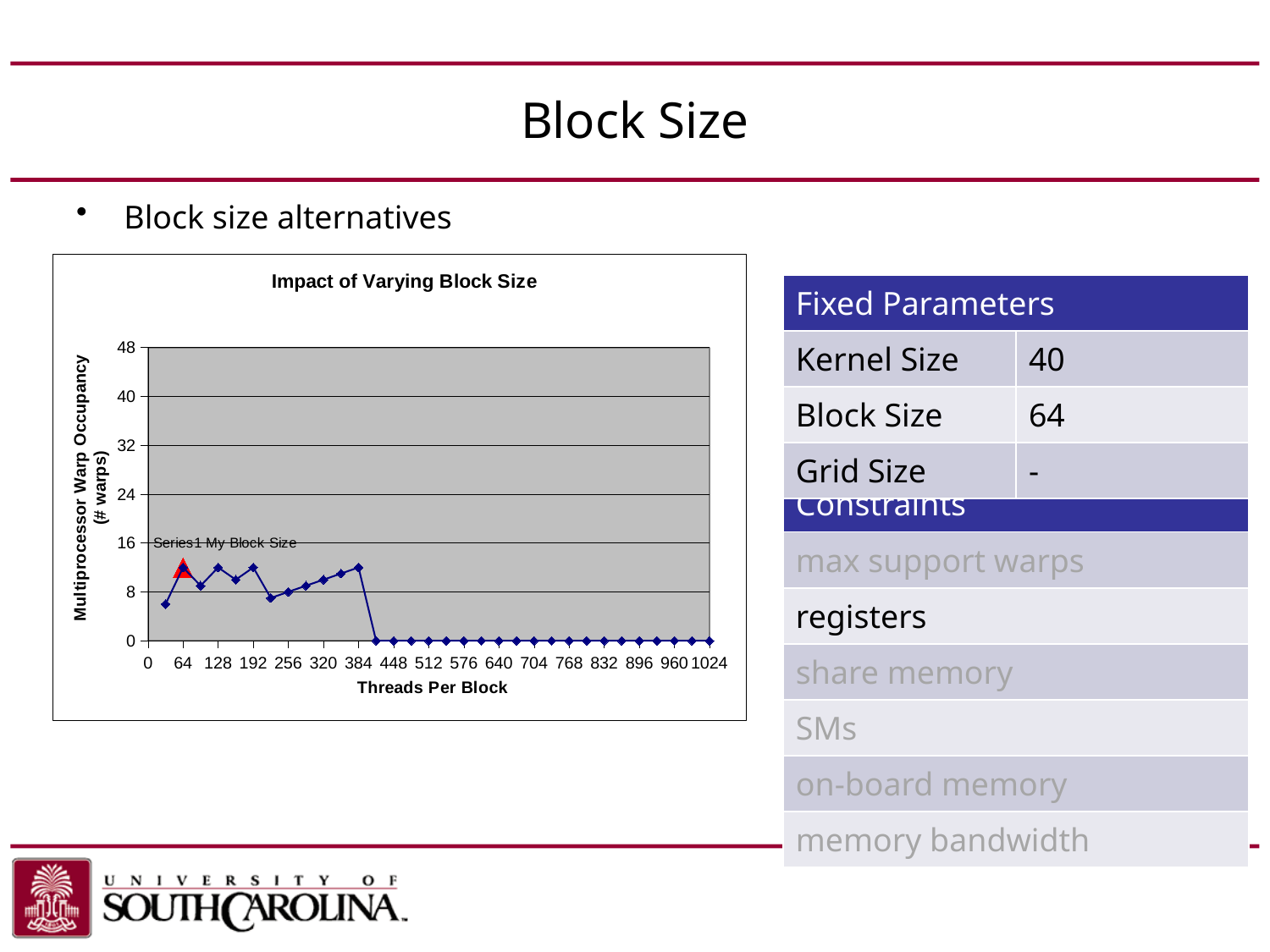
What is the title of the chart? Impact of Varying Block Size Which has the larger warp occupancy: 64 threads per block or 512 threads per block? 64 threads per block What is the label of the x axis of the chart? Threads Per Block What is the warp occupancy value for 512 threads per block? 0 What kind of chart is shown on the slide? line chart What is the warp occupancy value for 1024 threads per block? 0 Is the warp occupancy value for 64 threads per block greater or less than 8? greater How many series does the chart legend list? 2 Do the warp occupancy values rise or fall between 384 and 448 threads per block? fall Is the warp occupancy value for 384 threads per block greater or less than 16? less